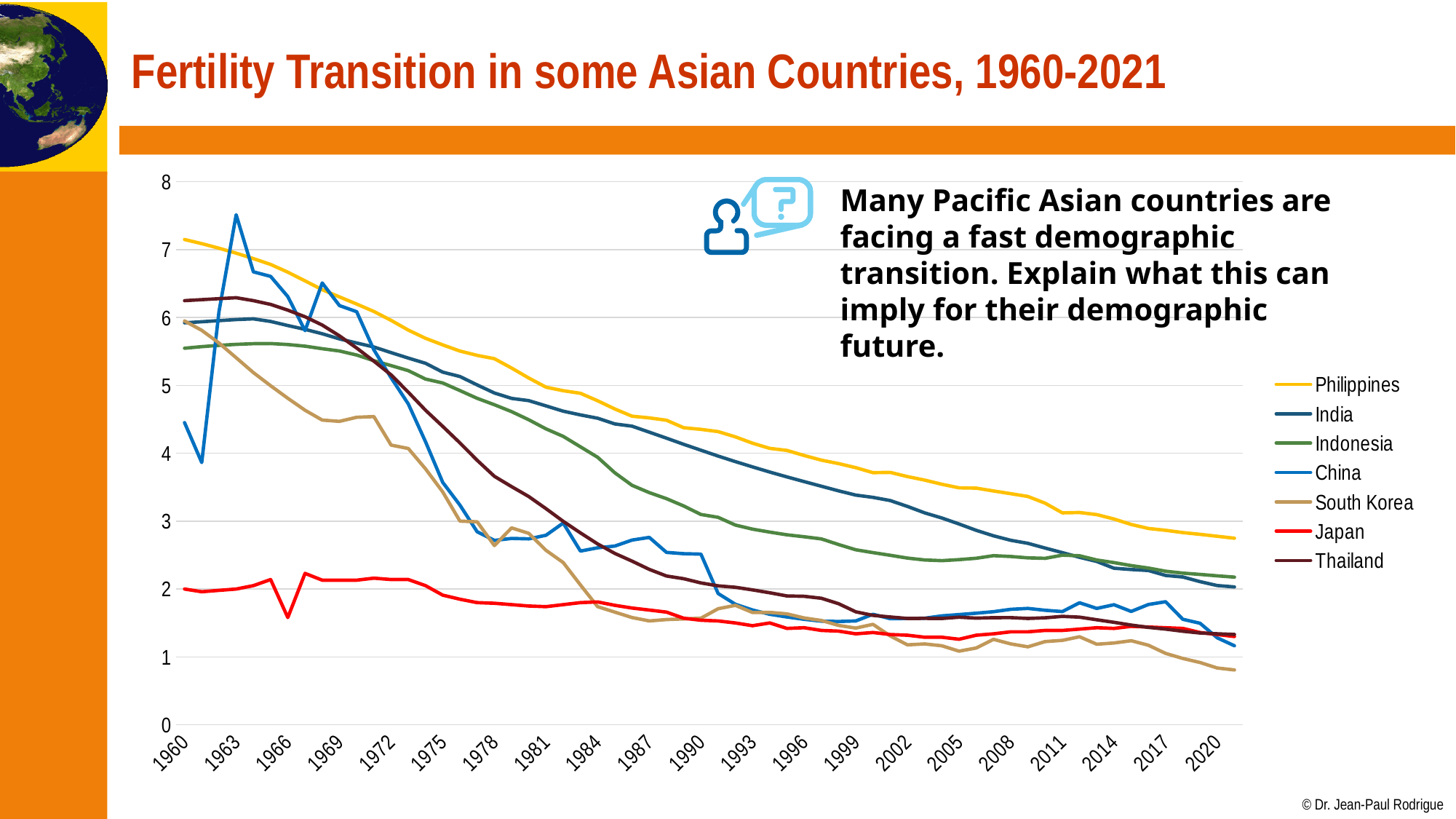
Which country has the lowest fertility value in 1960? Japan Does the Philippines line rise or fall from 1960 to 2021? fall What kind of chart is shown on the slide? line chart Which country has the highest fertility value in 2020? Philippines Which country has the lowest fertility value in 2020? South Korea Which country's line is shown in red in the legend? Japan Is the value for South Korea in 2020 greater or less than 1? less Which country has the highest fertility value in 1960? Philippines Is the value for China in 1963 greater or less than 7? greater How many series does the legend list? 7 Is the value for Philippines in 2020 greater or less than 2? greater What is the title of the chart on the slide? Fertility Transition in some Asian Countries, 1960-2021